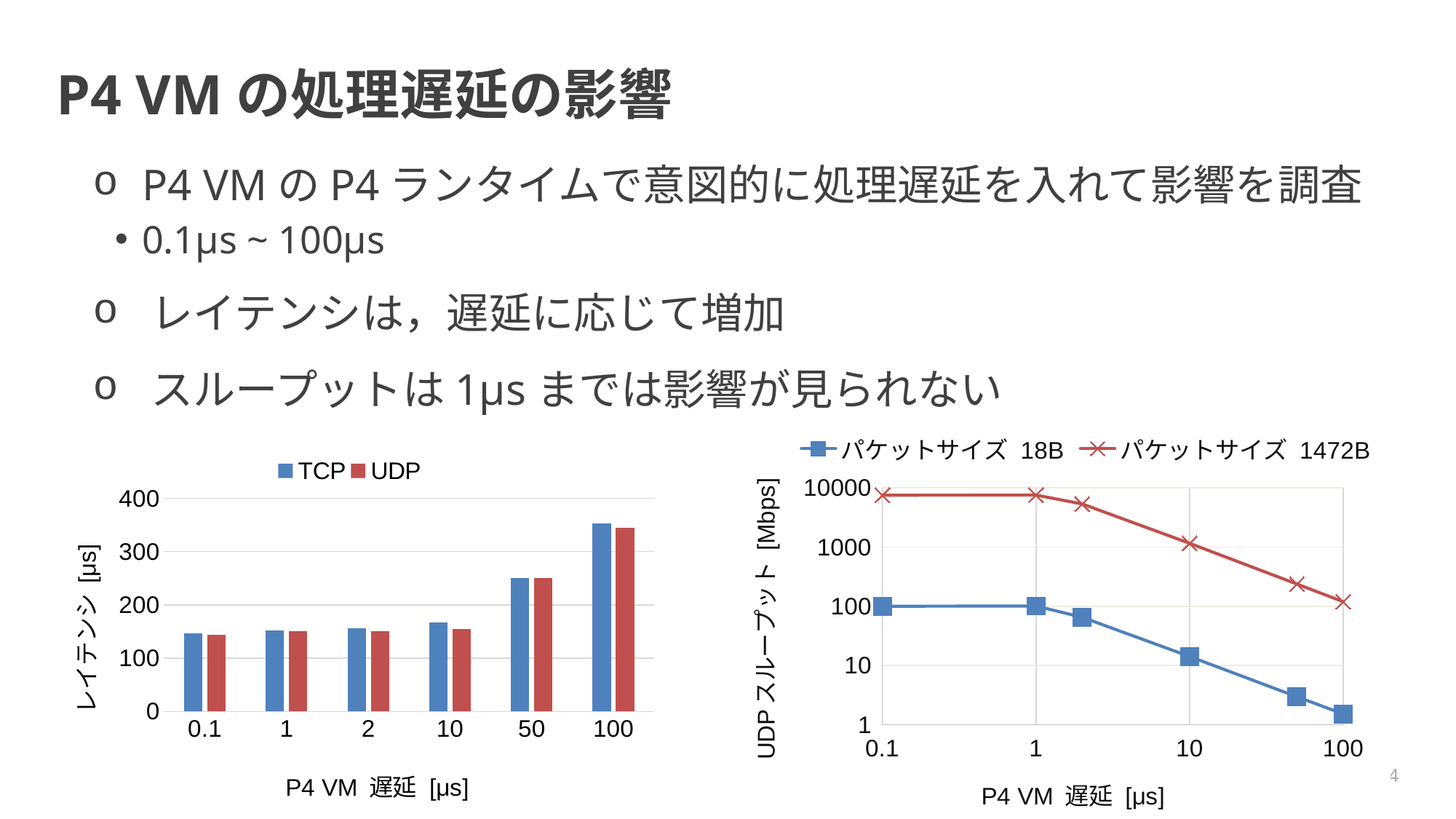
In the right chart (UDP スループット), does the パケットサイズ 1472B throughput rise or fall as P4 VM 遅延 increases along the x axis? fall What kind of chart is the right chart (UDP スループット)? line chart In the right chart (UDP スループット), is the パケットサイズ 18B value at 100 μs greater or less than 10? less In the left chart (レイテンシ), is the TCP value at 100 μs greater or less than 300? greater In the left chart (レイテンシ), which is larger: the UDP value at 50 or the UDP value at 2? UDP at 50 In the left chart (レイテンシ), do the latency values rise or fall as P4 VM 遅延 increases along the x axis? rise In the left chart (レイテンシ), how many series does the legend list? 2 In the right chart (UDP スループット), how many series does the legend list? 2 In the left chart (レイテンシ), is the UDP value at 10 μs greater or less than 200? less What kind of chart is the left chart (レイテンシ)? bar chart In the left chart (レイテンシ), at which P4 VM 遅延 value is the TCP latency highest? 100 In the left chart (レイテンシ), how many P4 VM 遅延 categories are shown on the x axis? 6